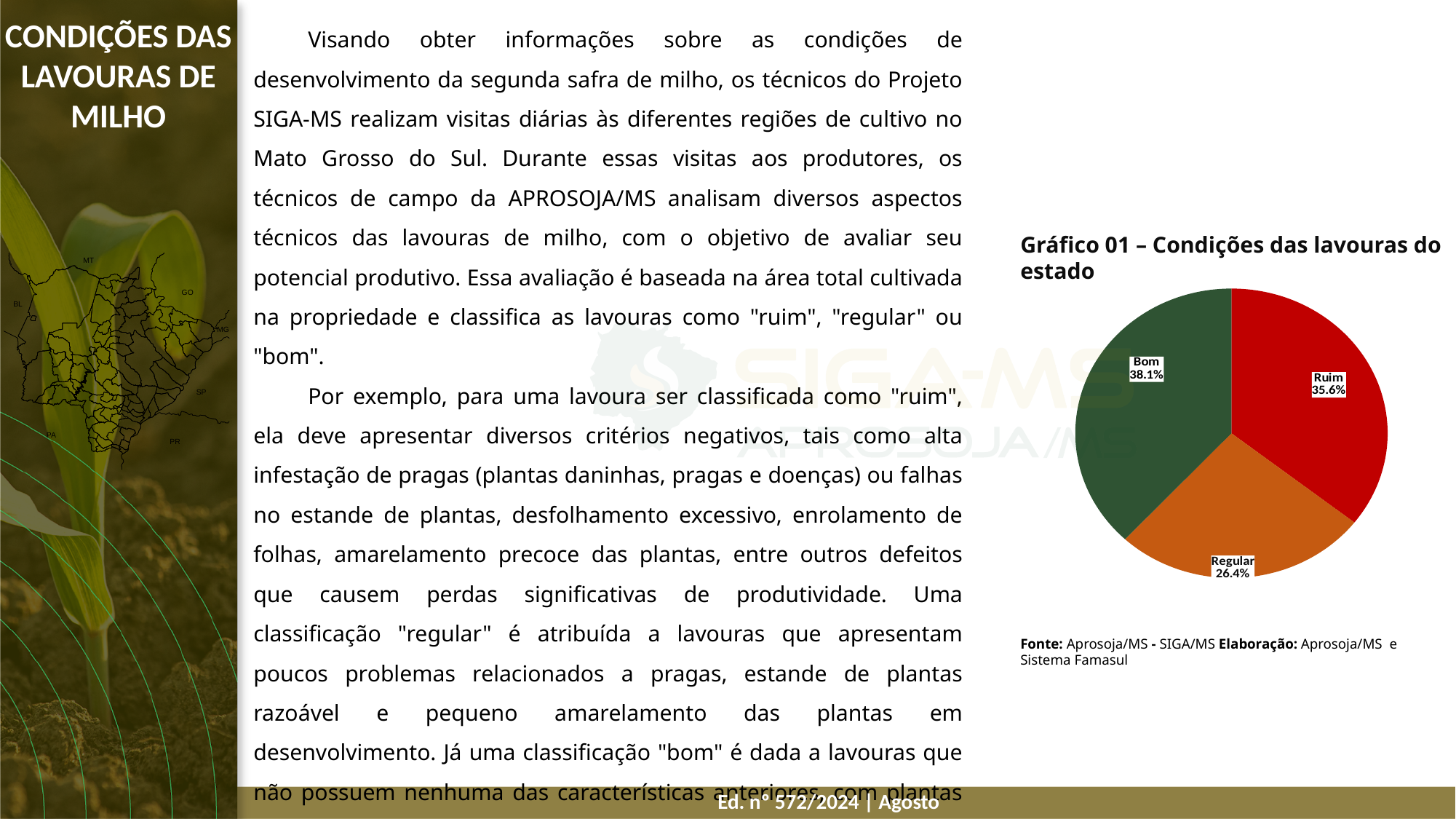
Which category has the smallest share of the pie? Regular Which category has the largest share of the pie? Bom How many categories are shown in the pie chart? 3 What is the title of the chart? Gráfico 01 – Condições das lavouras do estado What is the difference in percentage points between the Bom and Regular shares? 11.7 What is the share of lavouras classified as Bom? 38.1% What colour is the Ruim slice of the pie? red What is the difference in percentage points between the Bom and Ruim shares? 2.5 What type of chart is shown on the slide? pie chart Which is larger, the share for Ruim or the share for Regular? Ruim What is the share of lavouras classified as Regular? 26.4% What is the share of lavouras classified as Ruim? 35.6%